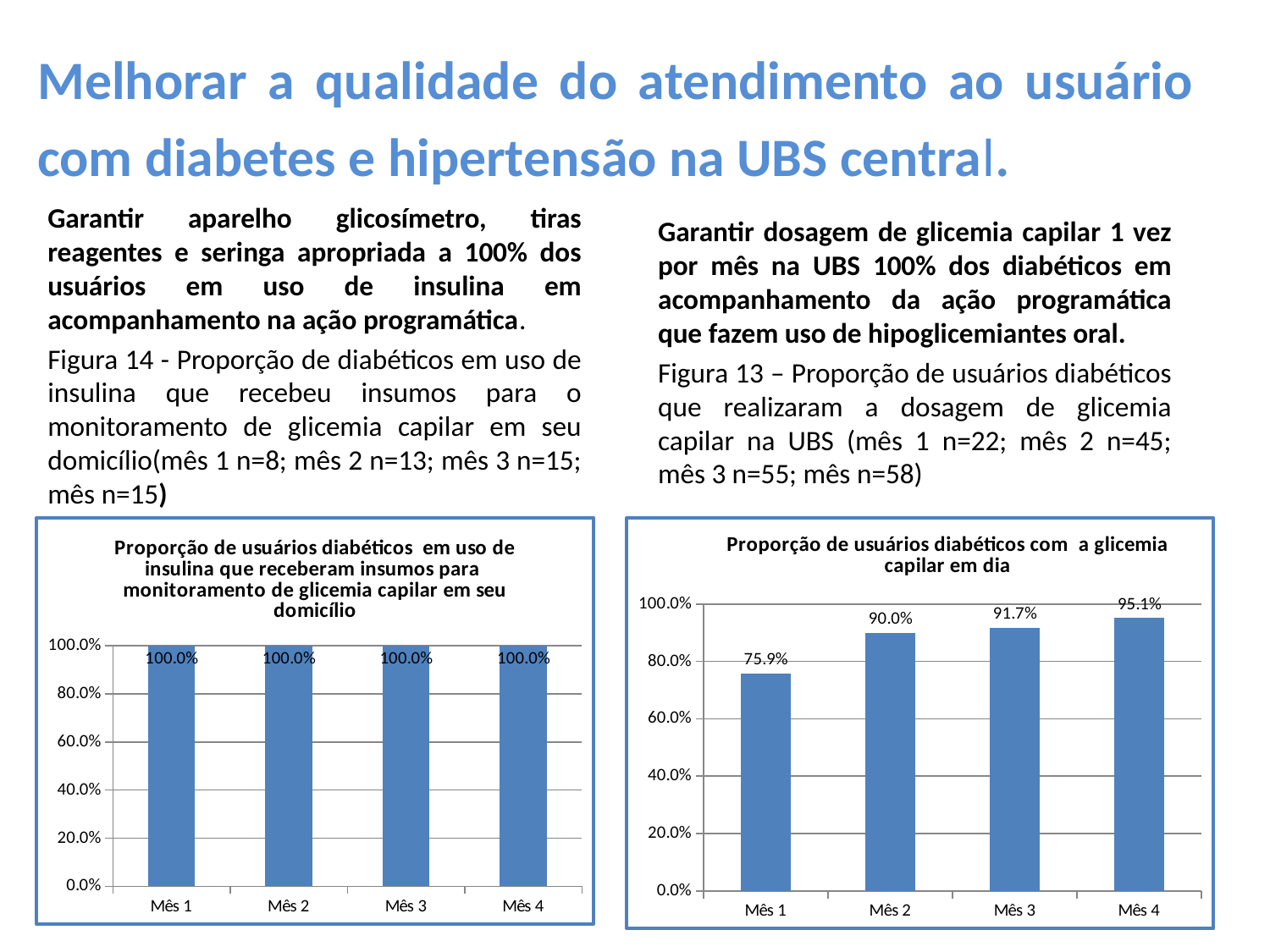
In the right chart (Proporção de usuários diabéticos com a glicemia capilar em dia), is the value for Mês 1 greater or less than 80.0%? less In the right chart (Proporção de usuários diabéticos com a glicemia capilar em dia), which is larger, the value for Mês 2 or Mês 3? Mês 3 In the right chart (Proporção de usuários diabéticos com a glicemia capilar em dia), which month has the lowest value? Mês 1 In the right chart (Proporção de usuários diabéticos com a glicemia capilar em dia), do the values rise or fall from Mês 1 to Mês 4? rise In the right chart (Proporção de usuários diabéticos com a glicemia capilar em dia), what is the value for Mês 3? 91.7% In the right chart (Proporção de usuários diabéticos com a glicemia capilar em dia), what is the difference between the values for Mês 4 and Mês 1? 19.2% In the right chart (Proporção de usuários diabéticos com a glicemia capilar em dia), which month has the highest value? Mês 4 In the left chart (Proporção de usuários diabéticos em uso de insulina que receberam insumos...), do the values rise, fall or stay the same from Mês 1 to Mês 4? stay the same In the left chart (Proporção de usuários diabéticos em uso de insulina que receberam insumos...), what is the value for Mês 2? 100.0% What kind of chart is the right chart (Proporção de usuários diabéticos com a glicemia capilar em dia)? bar chart In the right chart (Proporção de usuários diabéticos com a glicemia capilar em dia), what is the value for Mês 1? 75.9% How many months are shown in the left chart (Proporção de usuários diabéticos em uso de insulina que receberam insumos...)? 4